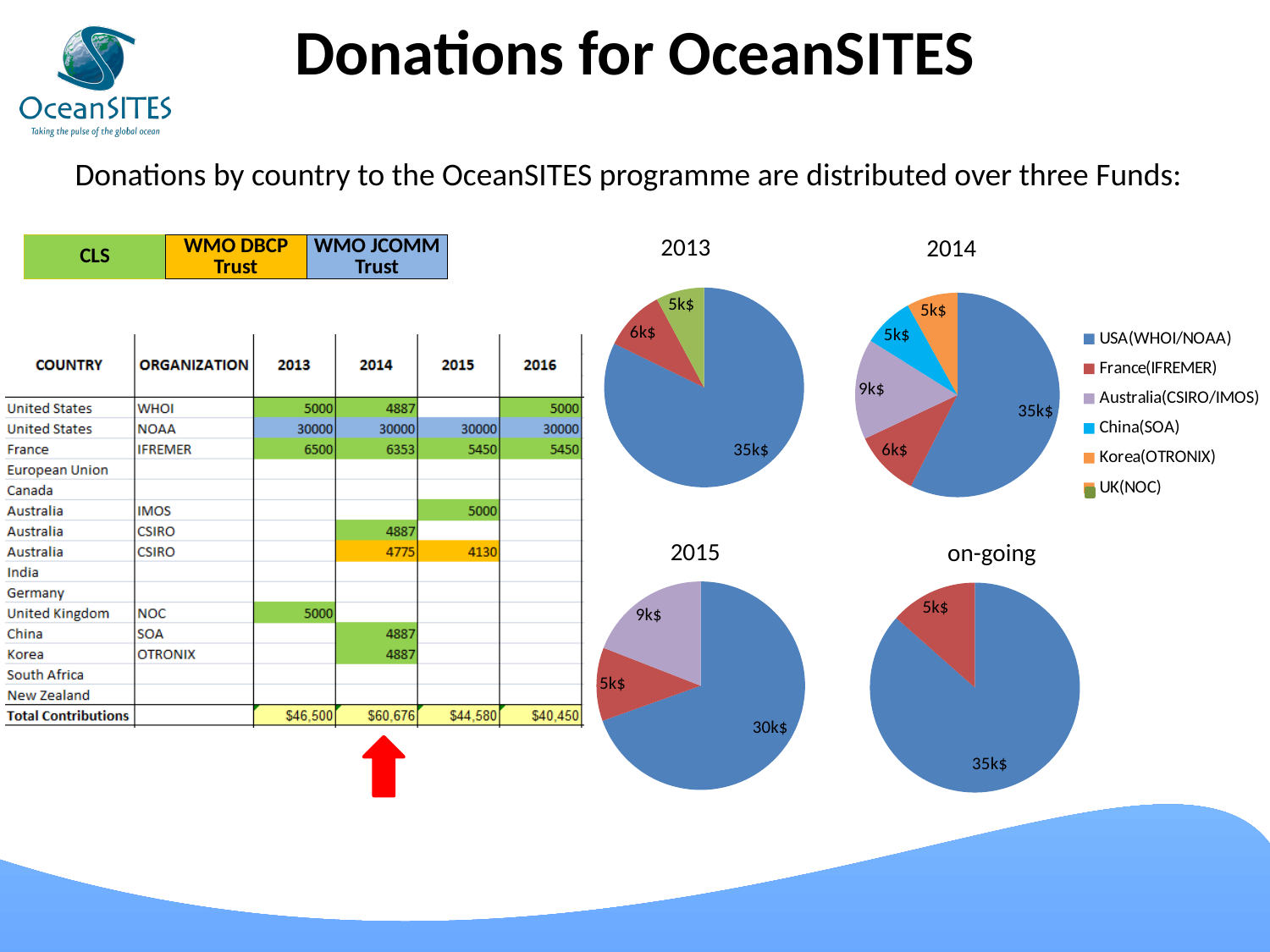
In the 2013 pie chart, what is the difference between the USA(WHOI/NOAA) slice and the France(IFREMER) slice? 29k$ How many entries does the shared legend for the pie charts list? 6 In the 2015 pie chart, what is the value of the France(IFREMER) slice? 5k$ In the 2014 pie chart, what is the value of the Australia(CSIRO/IMOS) slice? 9k$ How many slices does the 2014 pie chart have? 5 In the on-going pie chart, what is the value of the USA(WHOI/NOAA) slice? 35k$ How many slices does the on-going pie chart have? 2 In the 2014 pie chart, which is larger, the Australia(CSIRO/IMOS) slice or the France(IFREMER) slice? Australia(CSIRO/IMOS) In the 2015 pie chart, which country has the smallest slice? France(IFREMER) In the 2014 pie chart, which country has the largest slice? USA(WHOI/NOAA) What type of chart is used to show the 2015 donations? Pie chart In the 2013 pie chart, what is the value of the USA(WHOI/NOAA) slice? 35k$